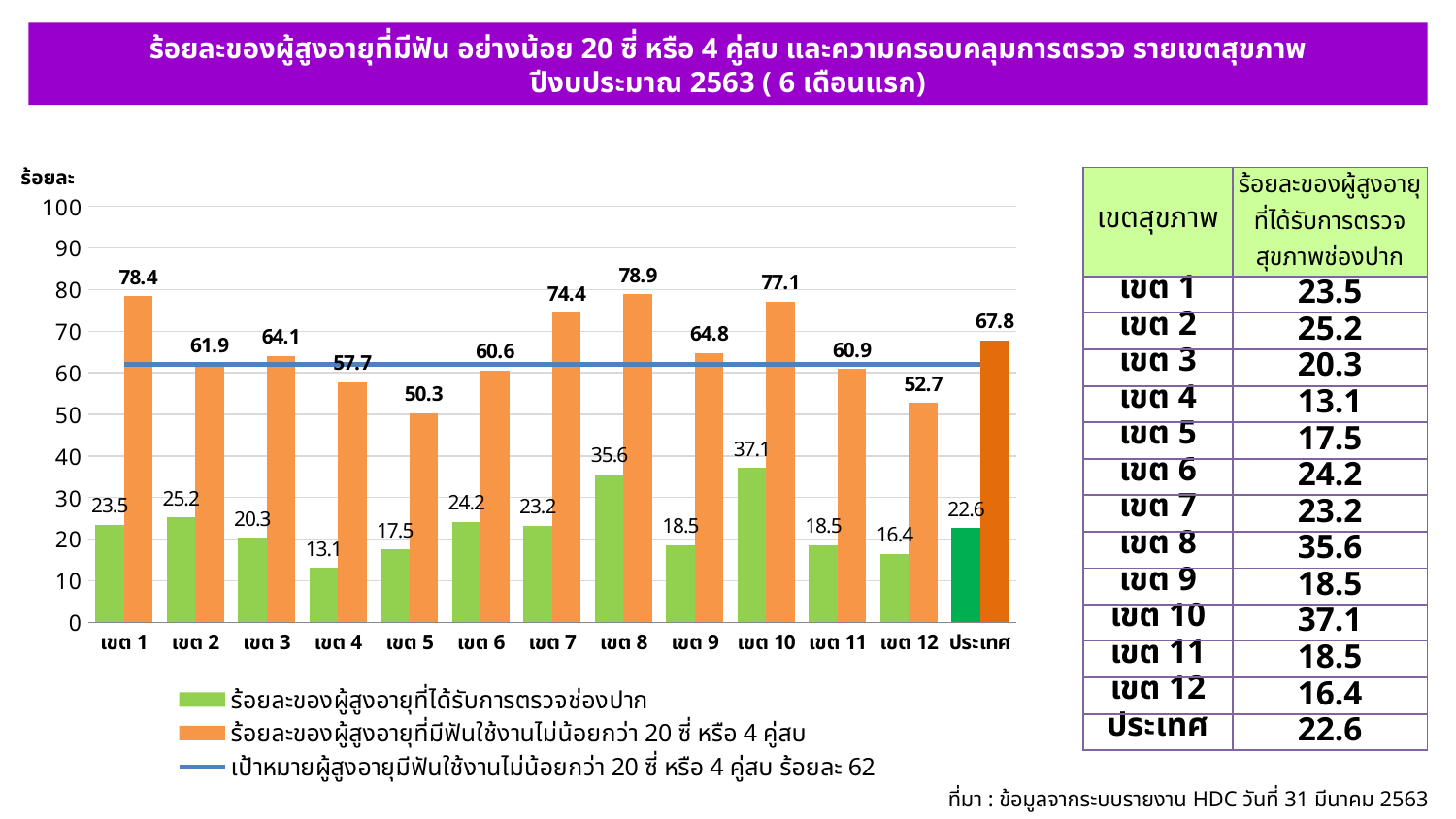
Which category has the lowest value in the green series? เขต 4 How many entries does the legend list? 3 What kind of chart is shown on the slide? combination bar and line chart What target value does the blue horizontal line represent, according to the legend? ร้อยละ 62 How many categories are shown on the x axis? 13 What is the value of the orange series (ร้อยละของผู้สูงอายุที่มีฟันใช้งานไม่น้อยกว่า 20 ซี่ หรือ 4 คู่สบ) for เขต 1? 78.4 Which category has the highest value in the orange series? เขต 8 What is the difference between the orange and green values for เขต 8? 43.3 Which is larger: the orange value for เขต 5 or the orange value for เขต 12? เขต 12 What is the value of the orange series for ประเทศ? 67.8 Is the orange value for เขต 4 greater or less than the target line of 62? less What is the value of the green series (ร้อยละของผู้สูงอายุที่ได้รับการตรวจช่องปาก) for เขต 10? 37.1